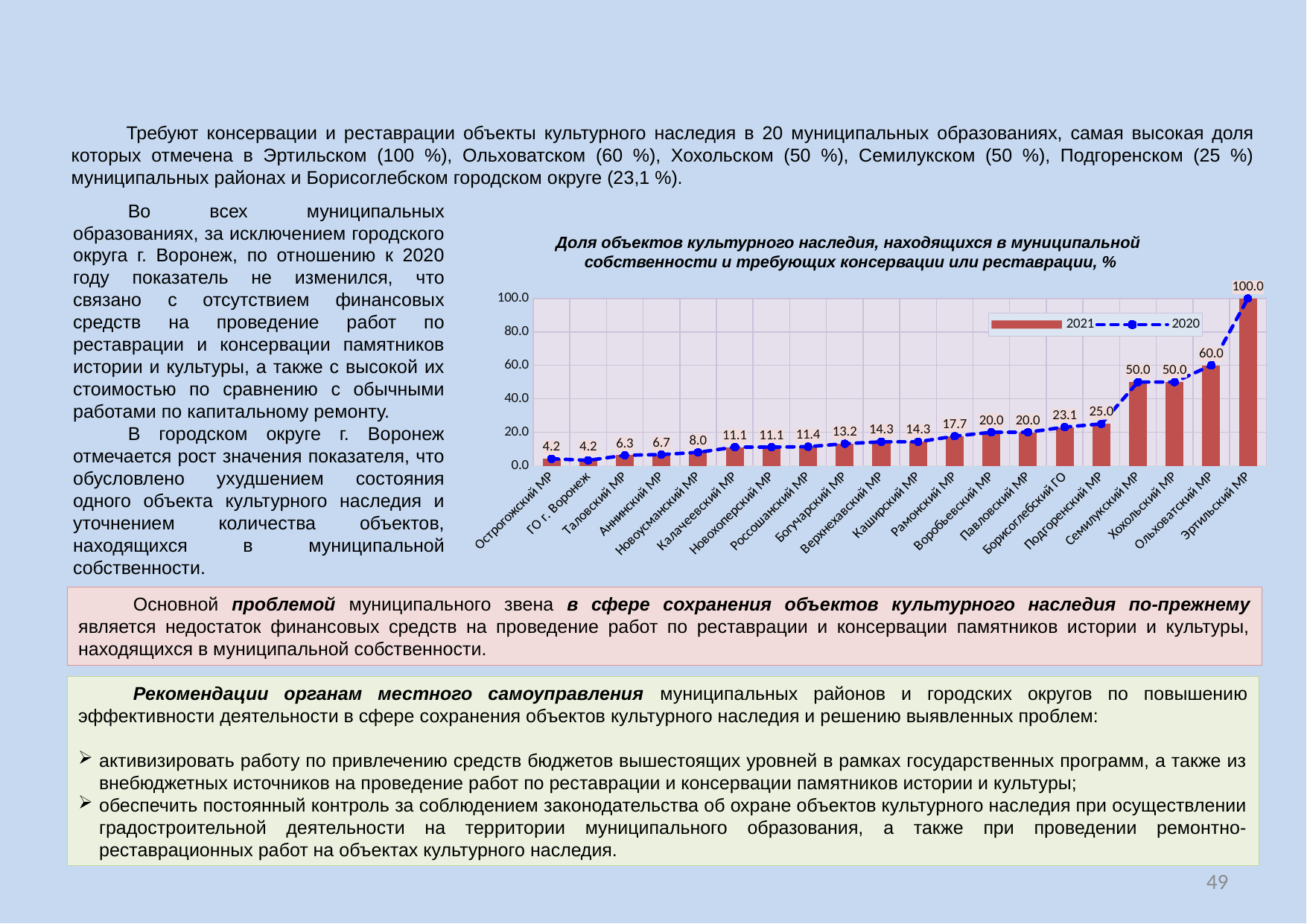
What is the difference between the 2021 values for Эртильский МР and Ольховатский МР? 40.0 How many series does the legend list? 2 What is the 2021 value for Эртильский МР? 100.0 Is the 2021 value for Семилукский МР greater or less than 40.0? greater What is the 2021 value for Рамонский МР? 17.7 What is the difference between the 2021 values for Подгоренский МР and Борисоглебский ГО? 1.9 What is the 2021 value for Ольховатский МР? 60.0 What is the 2021 value for Борисоглебский ГО? 23.1 How many categories are shown on the x axis? 20 Which series is shown as a dashed line with markers? 2020 Which category has the highest 2021 value? Эртильский МР Which has a larger 2021 value, Богучарский МР or Новоусманский МР? Богучарский МР